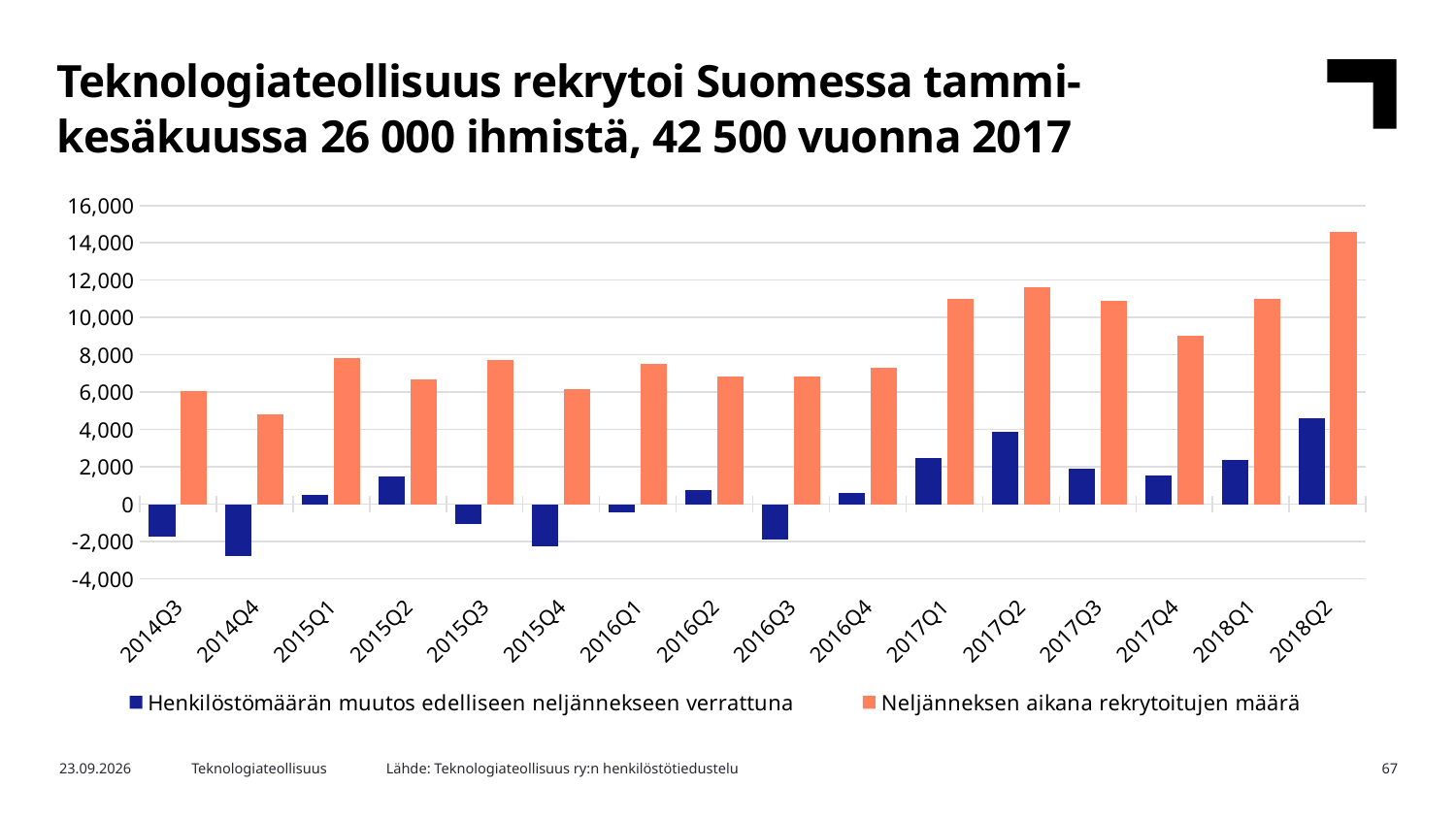
How many series does the chart's legend list? 2 In which quarter is the value for 'Henkilöstömäärän muutos edelliseen neljännekseen verrattuna' highest? 2018Q2 What kind of chart is shown on the slide? bar chart Is the value for 'Henkilöstömäärän muutos edelliseen neljännekseen verrattuna' in 2014Q4 greater or less than -2,000? less Is the value for 'Neljänneksen aikana rekrytoitujen määrä' in 2014Q4 greater or less than 6,000? less In which quarter is the value for 'Neljänneksen aikana rekrytoitujen määrä' highest? 2018Q2 How many quarters are shown on the x axis of the chart? 16 In which quarter is the value for 'Neljänneksen aikana rekrytoitujen määrä' lowest? 2014Q4 Which quarter has a larger value for 'Neljänneksen aikana rekrytoitujen määrä', 2017Q2 or 2017Q4? 2017Q2 Is the value for 'Neljänneksen aikana rekrytoitujen määrä' in 2018Q2 greater or less than 14,000? greater In which quarter is the value for 'Henkilöstömäärän muutos edelliseen neljännekseen verrattuna' lowest? 2014Q4 Which colour represents 'Neljänneksen aikana rekrytoitujen määrä' in the chart? orange